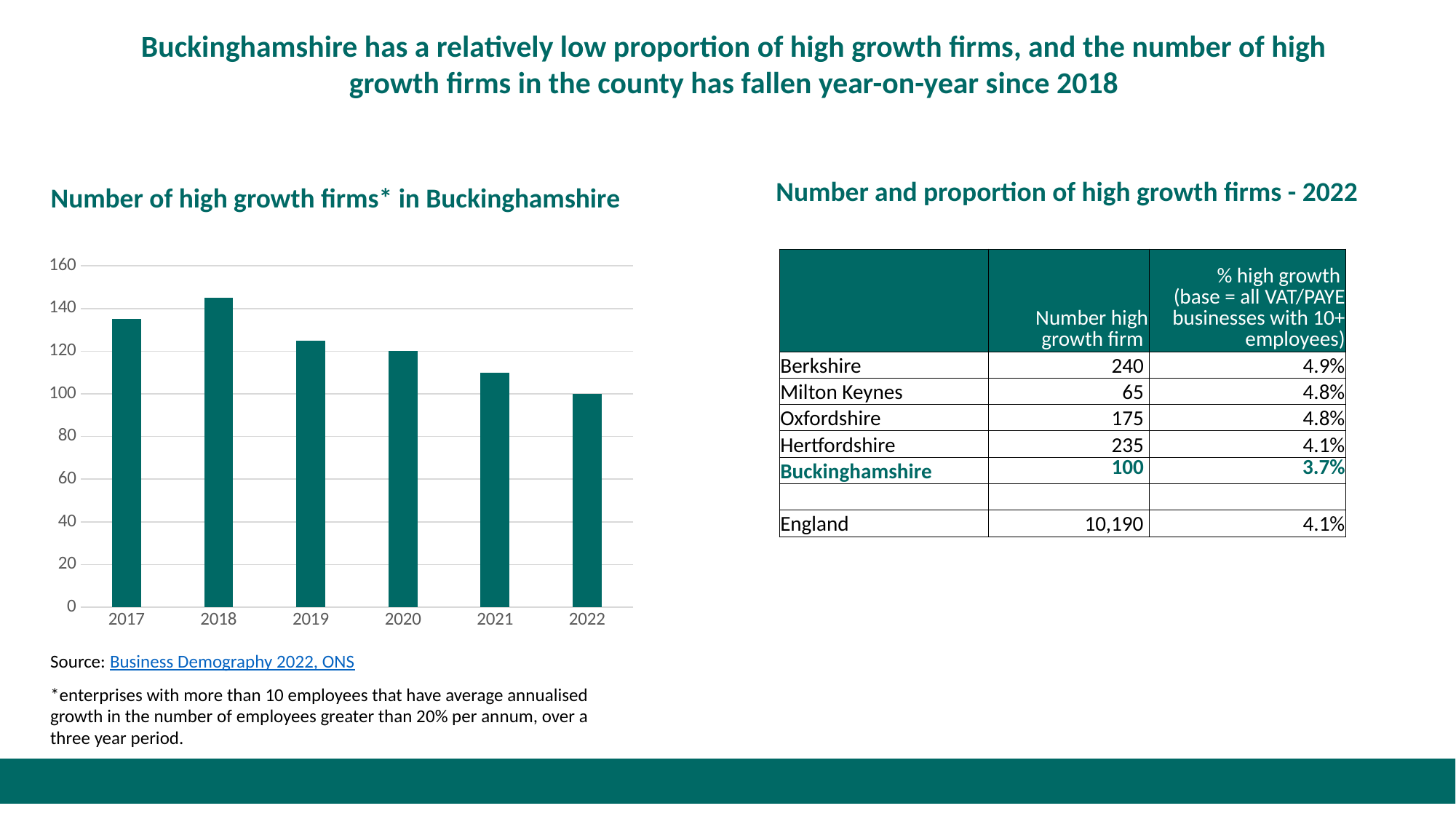
In which year was the number of high growth firms in Buckinghamshire lowest? 2022 How many years are shown on the x axis of the bar chart? 6 In which year was the number of high growth firms in Buckinghamshire highest? 2018 What is the title of the bar chart? Number of high growth firms* in Buckinghamshire Do the values in the bar chart rise or fall from 2018 to 2022? Fall Is the value for 2021 in the bar chart greater or less than 100? greater What is the number of high growth firms in Buckinghamshire in 2022 according to the bar chart? 100 Which year has more high growth firms in the bar chart, 2017 or 2019? 2017 What kind of chart is used to show the number of high growth firms in Buckinghamshire? Bar chart Is the value for 2017 in the bar chart greater or less than 120? greater Is the value for 2019 in the bar chart greater or less than 140? less What is the first year shown on the x axis of the bar chart? 2017